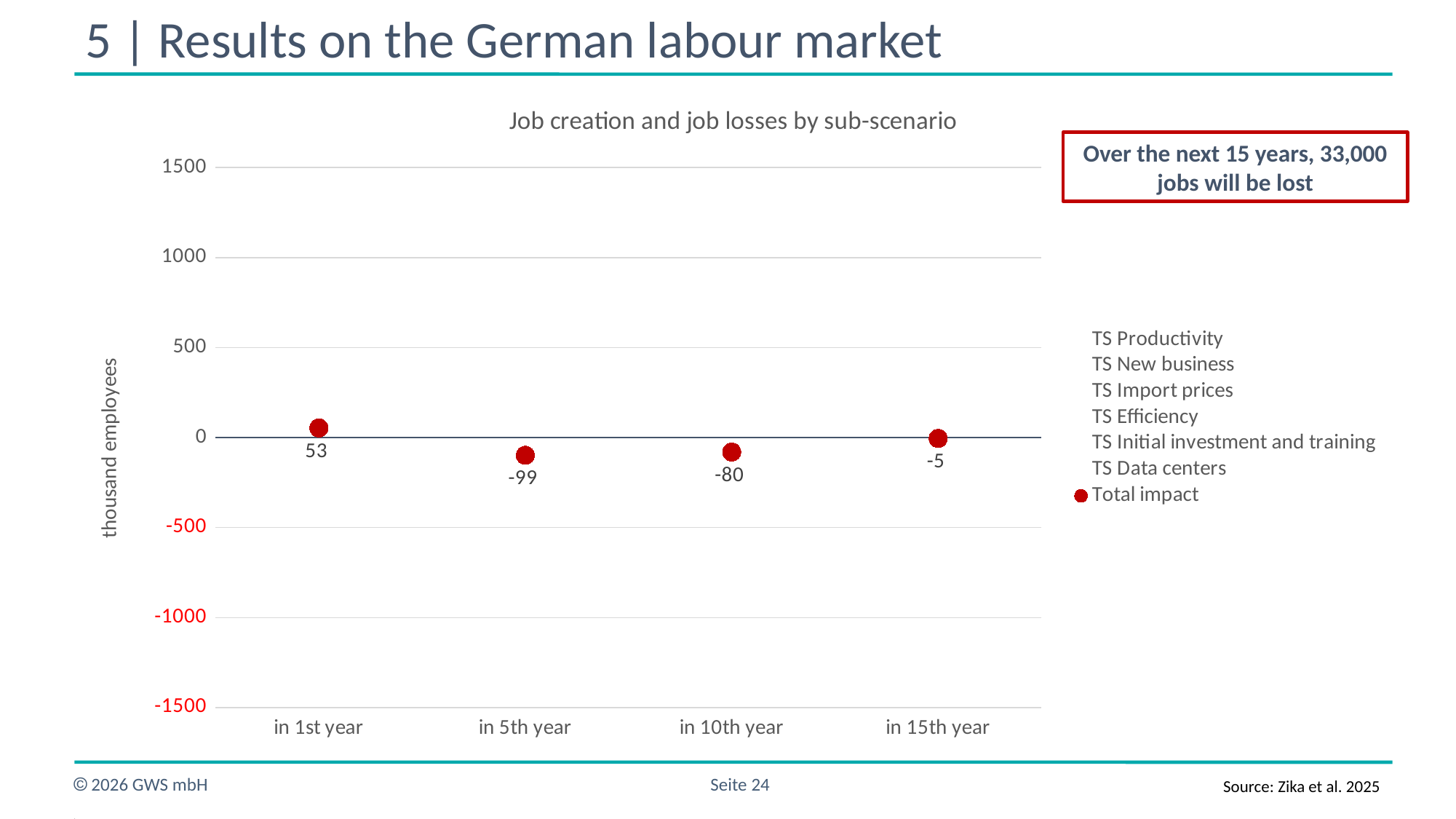
In which year is the Total impact highest? in 1st year How many entries does the legend list? 7 What is the difference between the Total impact in the 1st year and in the 5th year? 152 Which is larger, the Total impact in the 10th year or in the 15th year? in 15th year What is the Total impact value in the 15th year? -5 What is the Total impact value in the 10th year? -80 In which year is the Total impact lowest? in 5th year What is the title of the chart? Job creation and job losses by sub-scenario Is the Total impact value in the 5th year greater or less than 0? less What is the Total impact value in the 5th year? -99 What is the Total impact value in the 1st year? 53 How many year categories are shown on the x axis? 4